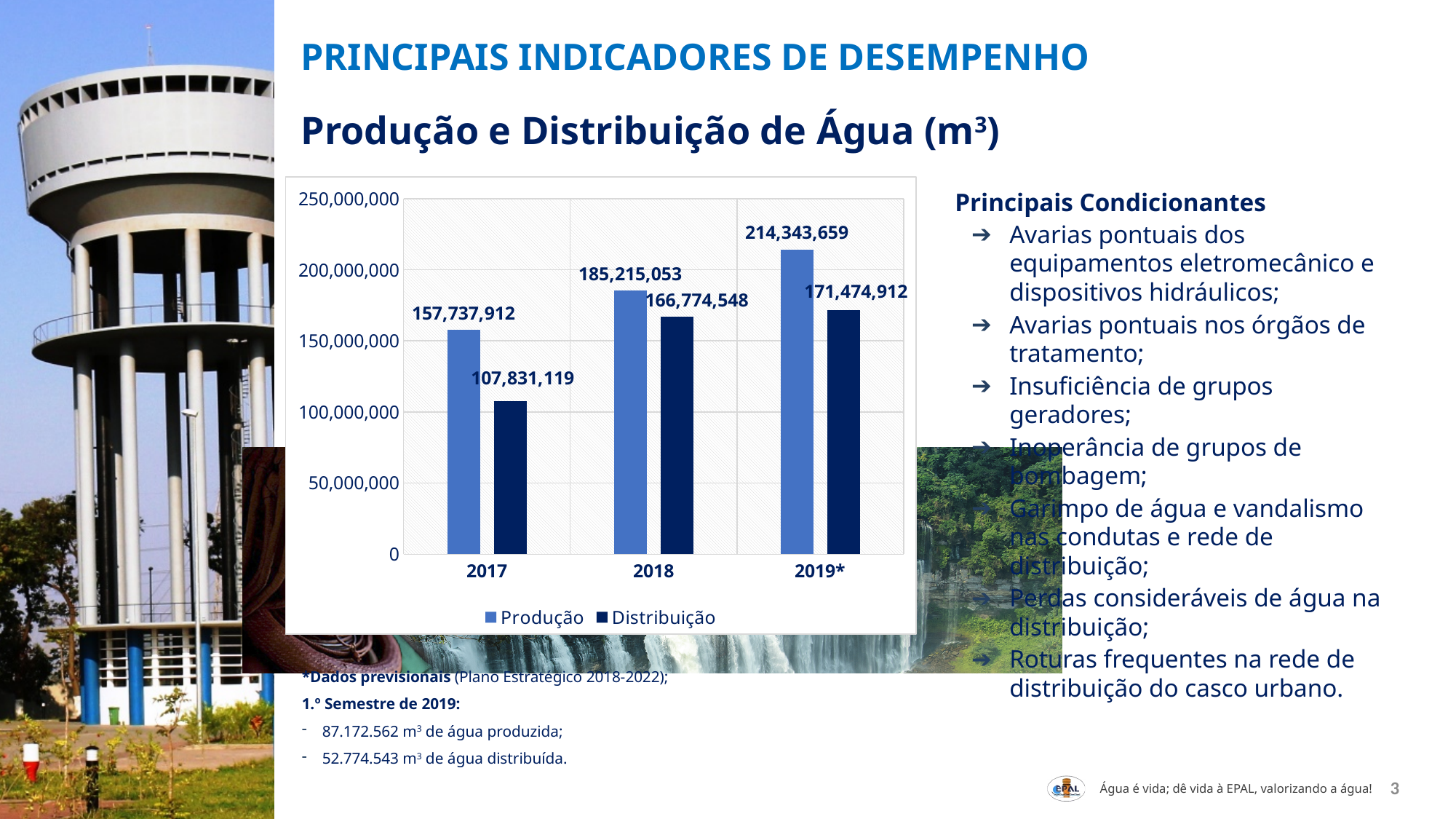
Which is larger in 2018, Produção or Distribuição? Produção What is the Distribuição value for 2018? 166,774,548 How many series does the legend list? 2 What is the Produção value for 2019*? 214,343,659 What is the difference between Produção and Distribuição in 2019*? 42,868,747 Which year has the highest Produção value? 2019* Does the Produção value rise or fall from 2017 to 2019*? rise Which year has the lowest Distribuição value? 2017 How many years are shown on the x axis? 3 What is the Distribuição value for 2017? 107,831,119 What is the difference between Produção and Distribuição in 2017? 49,906,793 What is the Produção value for 2017? 157,737,912